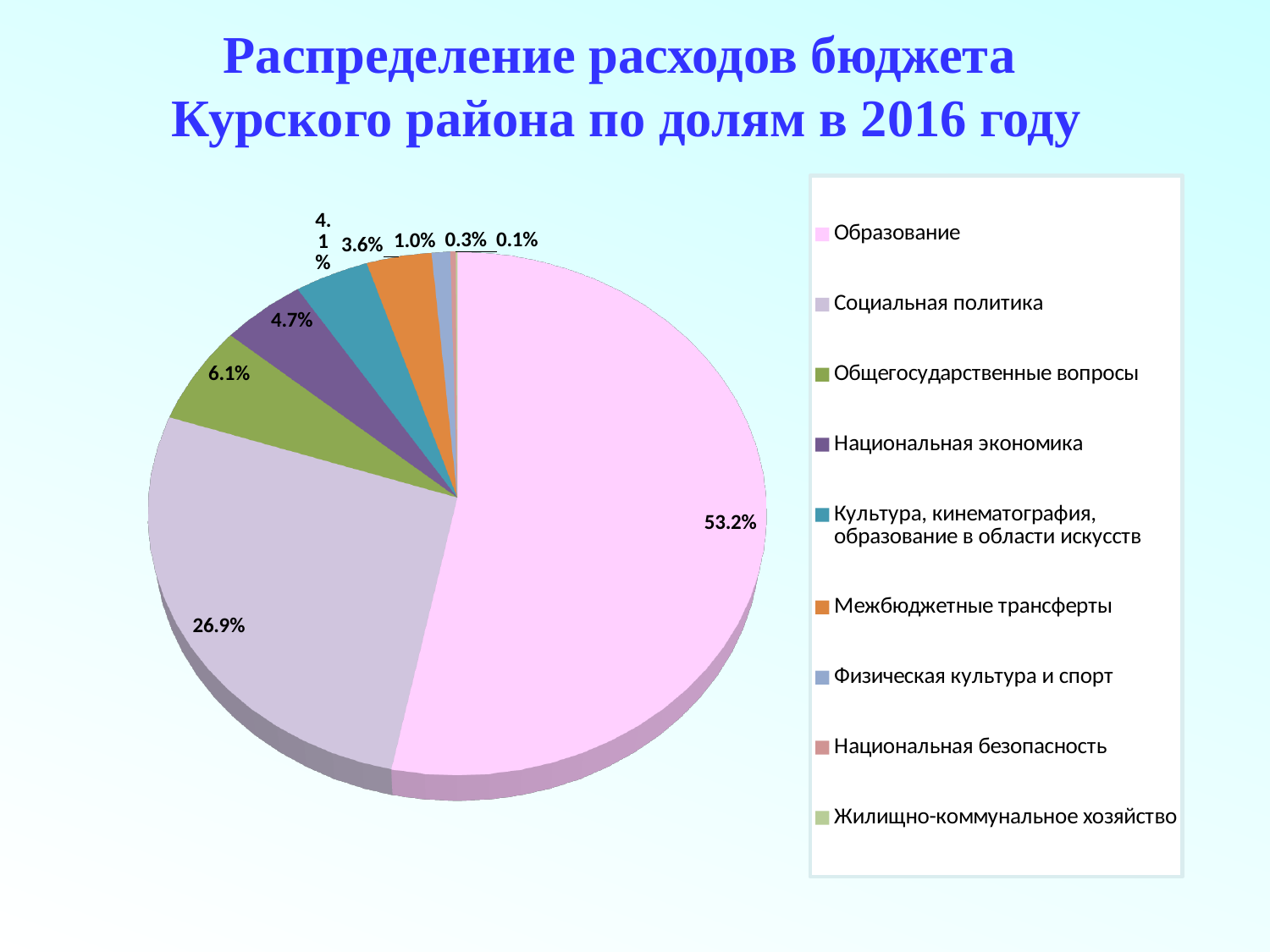
Which category has the largest share of the pie? Образование What share is shown for Национальная экономика? 4.7% Which category has the smallest share of the pie? Жилищно-коммунальное хозяйство How many categories does the legend list? 9 Which has a larger share: Национальная экономика or Межбюджетные трансферты? Национальная экономика What is the title of the slide? Распределение расходов бюджета Курского района по долям в 2016 году What share is shown for Межбюджетные трансферты? 3.6% What share of the budget expenditure goes to Образование? 53.2% What is the difference in percentage points between the shares of Образование and Социальная политика? 26.3 What type of chart is shown on the slide? Pie chart What share of the budget expenditure goes to Социальная политика? 26.9% What share is shown for Общегосударственные вопросы? 6.1%